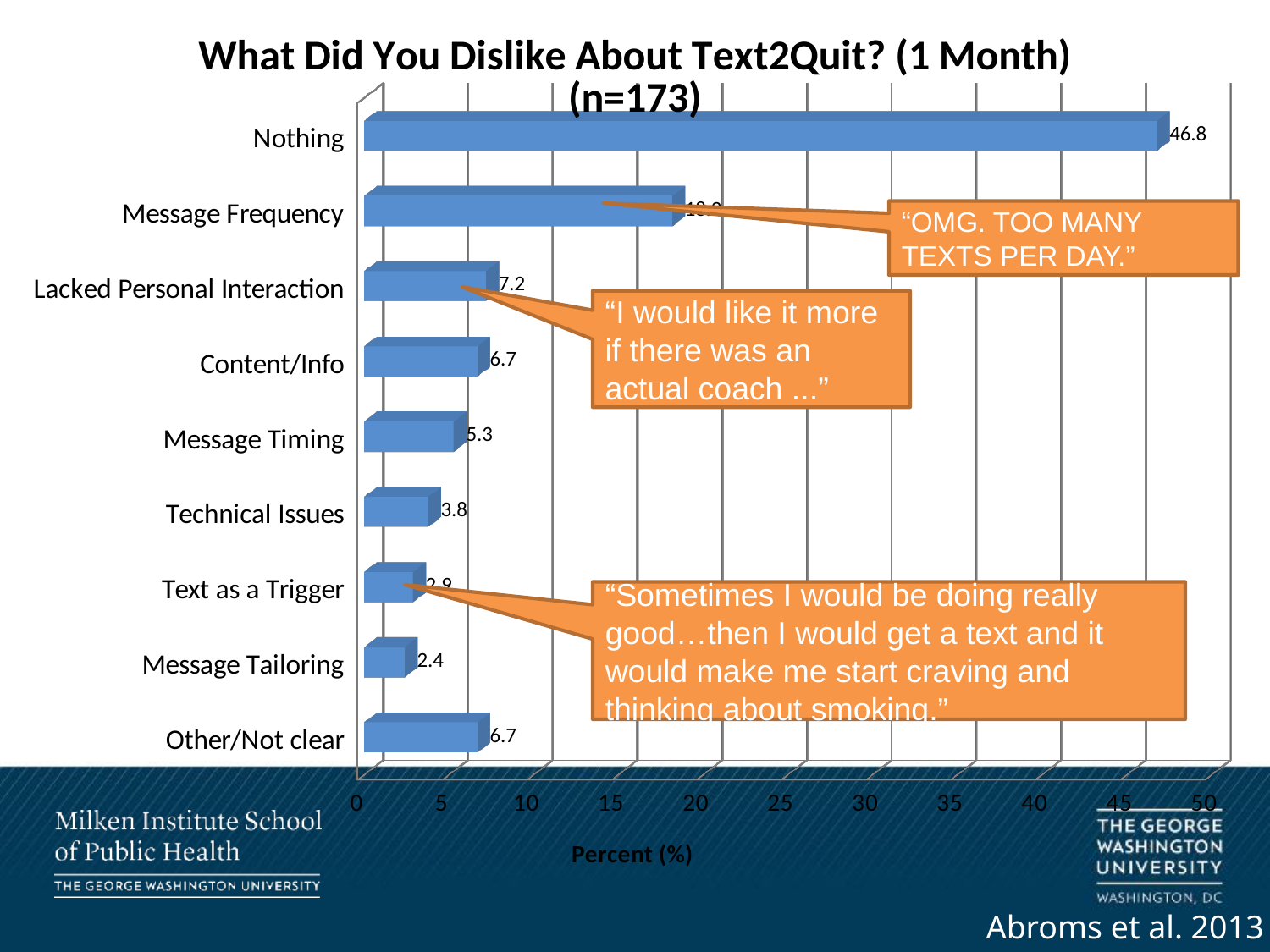
Which is larger, the value for Technical Issues or the value for Content/Info? Content/Info What is the value for Lacked Personal Interaction? 7.2 What is the difference between the values for Message Timing and Technical Issues? 1.5 What is the difference between the values for Nothing and Lacked Personal Interaction? 39.6 Which category has the highest value? Nothing What is the value for Nothing? 46.8 Is the value for Message Frequency greater or less than 20? less What type of chart is shown on the slide? bar chart How many categories are shown in the chart? 9 Which category has the lowest value? Message Tailoring What is the value for Message Tailoring? 2.4 What is the value for Message Timing? 5.3